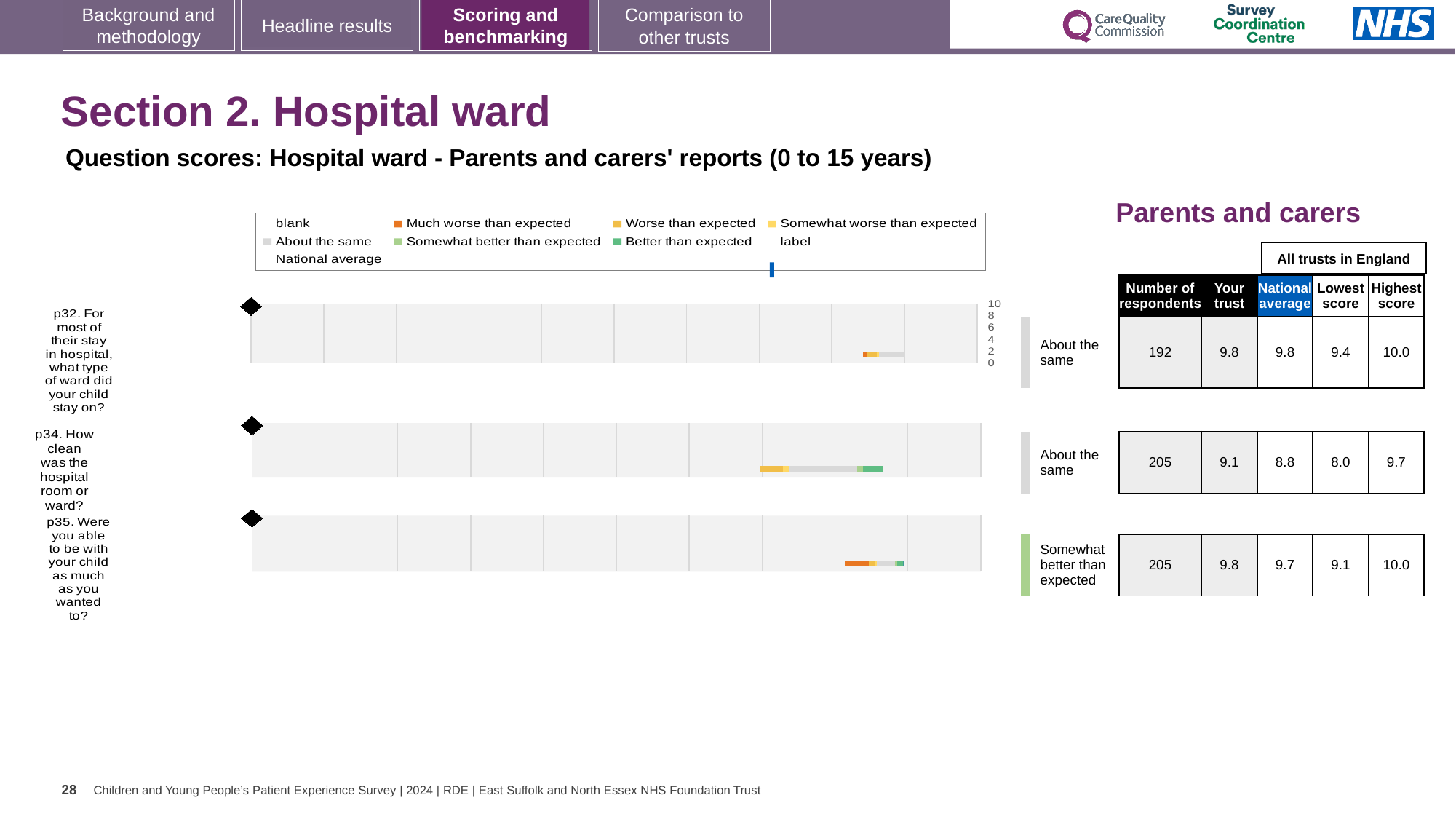
What benchmark category is shown for p35 (Were you able to be with your child as much as you wanted to?)? Somewhat better than expected What is the highest score across all trusts in England for p35 (Were you able to be with your child as much as you wanted to?)? 10.0 For p34, which is larger: the 'Your trust' score or the national average? Your trust What kind of chart is used to show the question scores on this slide? bar chart For p34, what is the difference between the 'Your trust' score and the national average? 0.3 What is the national average score for p34 (How clean was the hospital room or ward?)? 8.8 How many questions (categories) are plotted in the question scores chart? 3 How many respondents answered p32 (what type of ward did your child stay on)? 192 Which question has the lowest 'Your trust' score? p34. How clean was the hospital room or ward? What is the 'Your trust' score for p34 (How clean was the hospital room or ward?)? 9.1 What is the lowest score across all trusts in England for p34 (How clean was the hospital room or ward?)? 8.0 What colour represents 'Better than expected' in the chart legend? green